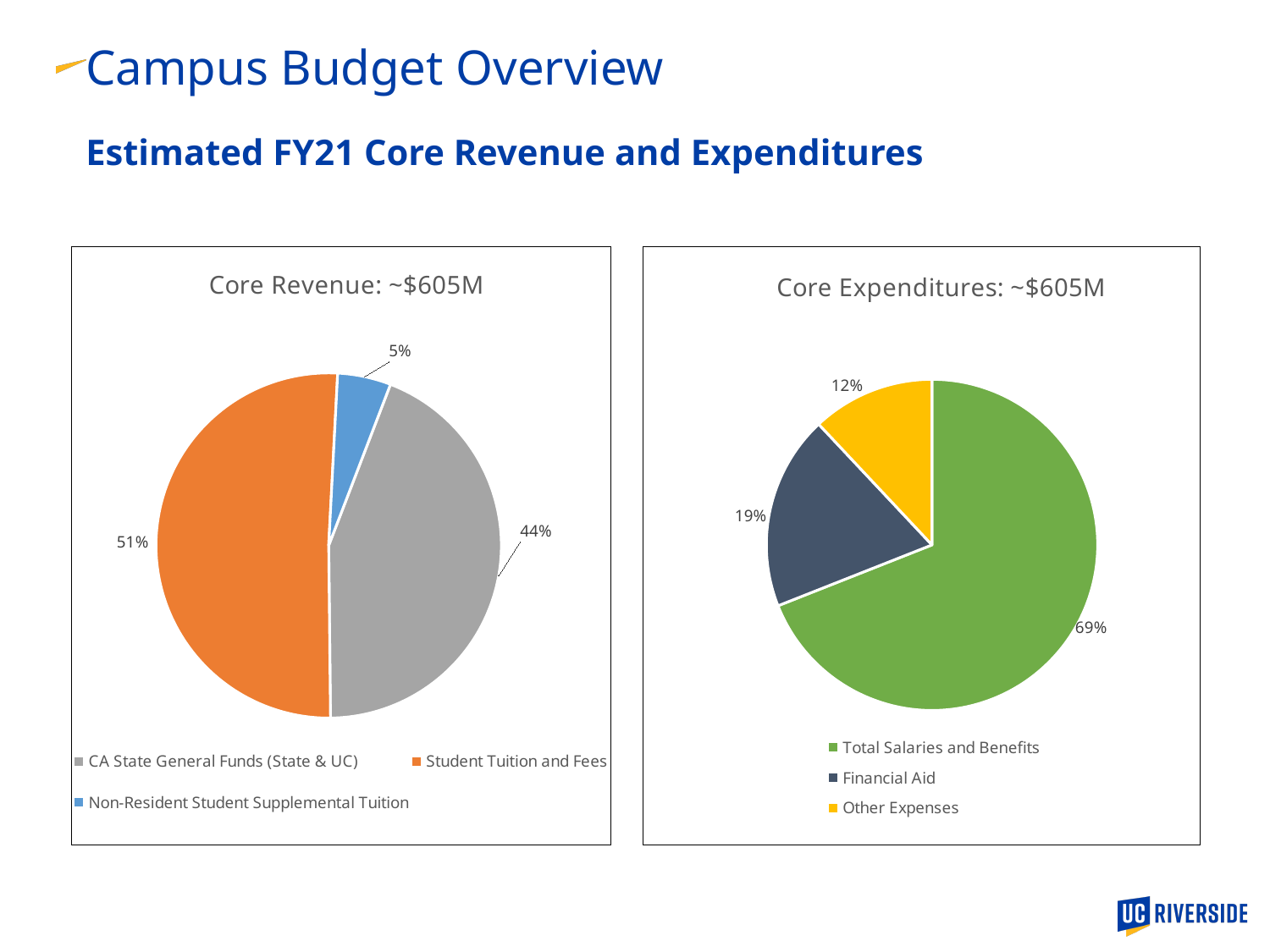
What kind of chart is the Core Revenue chart? Pie chart In the Core Expenditures chart, what share of expenditures goes to Total Salaries and Benefits? 69% In the Core Expenditures chart, what share of expenditures goes to Financial Aid? 19% In the Core Revenue chart, what share of revenue comes from CA State General Funds (State & UC)? 44% In the Core Expenditures chart, which category has the largest share? Total Salaries and Benefits In the Core Expenditures chart, how many categories does the legend list? 3 In the Core Revenue chart, which category has the largest share? Student Tuition and Fees In the Core Revenue chart, which category has the smallest share? Non-Resident Student Supplemental Tuition In the Core Revenue chart, what is the difference in percentage points between Student Tuition and Fees and CA State General Funds (State & UC)? 7 percentage points